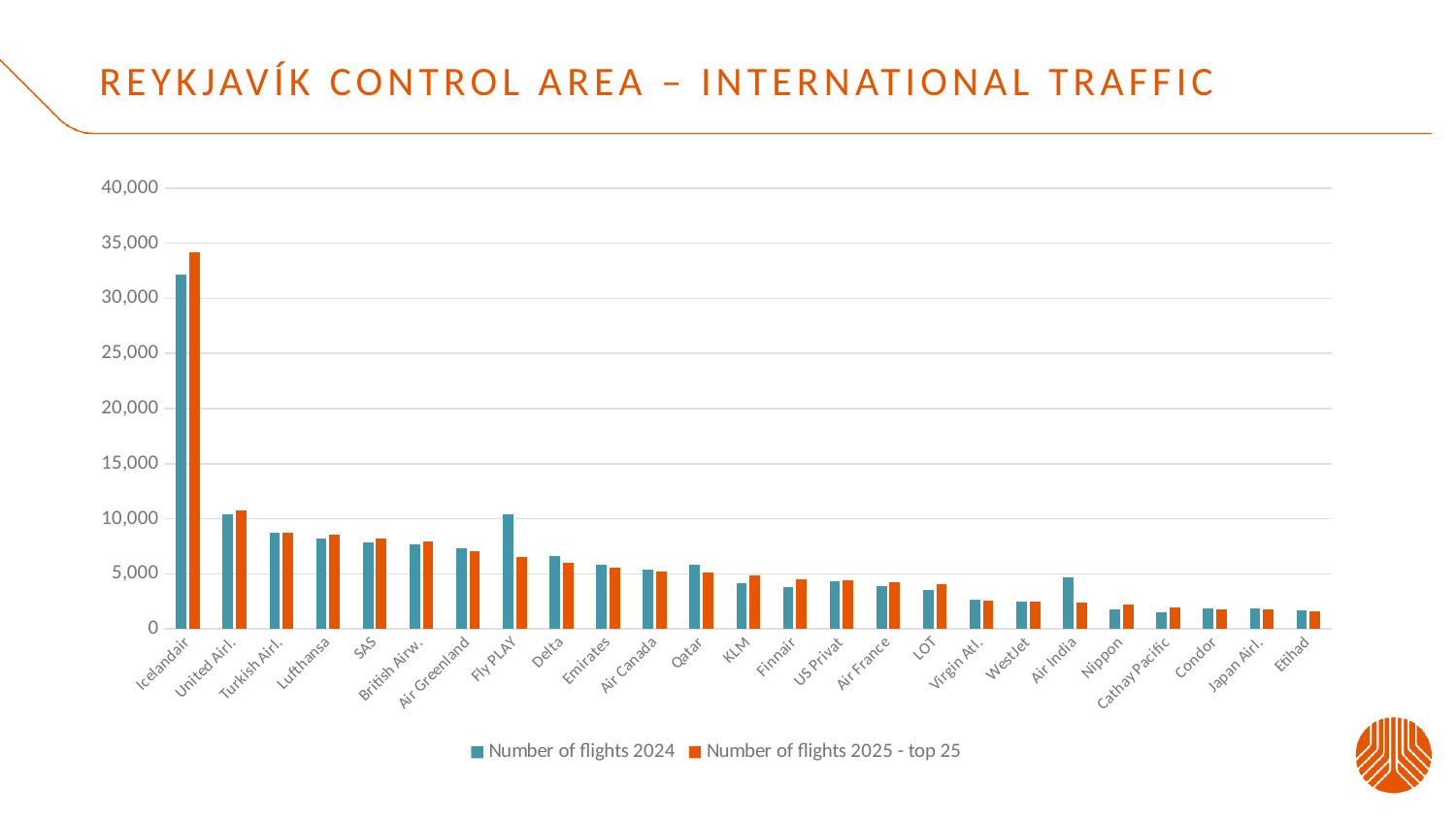
What kind of chart is shown on the slide? Bar chart What colour are the bars for the 'Number of flights 2025 - top 25' series? Orange For Icelandair, which is larger: the number of flights in 2024 or in 2025? 2025 Which airline has the highest number of flights in 2025? Icelandair Is the number of flights 2024 for Lufthansa greater or less than 10,000? less Is the number of flights 2025 for Icelandair greater or less than 35,000? less Is the number of flights 2024 for Icelandair greater or less than 30,000? greater How many series does the legend list? 2 How many airlines are shown on the x axis? 25 For Fly PLAY, which is larger: the number of flights in 2024 or in 2025? 2024 Which airline has the highest number of flights in 2024? Icelandair